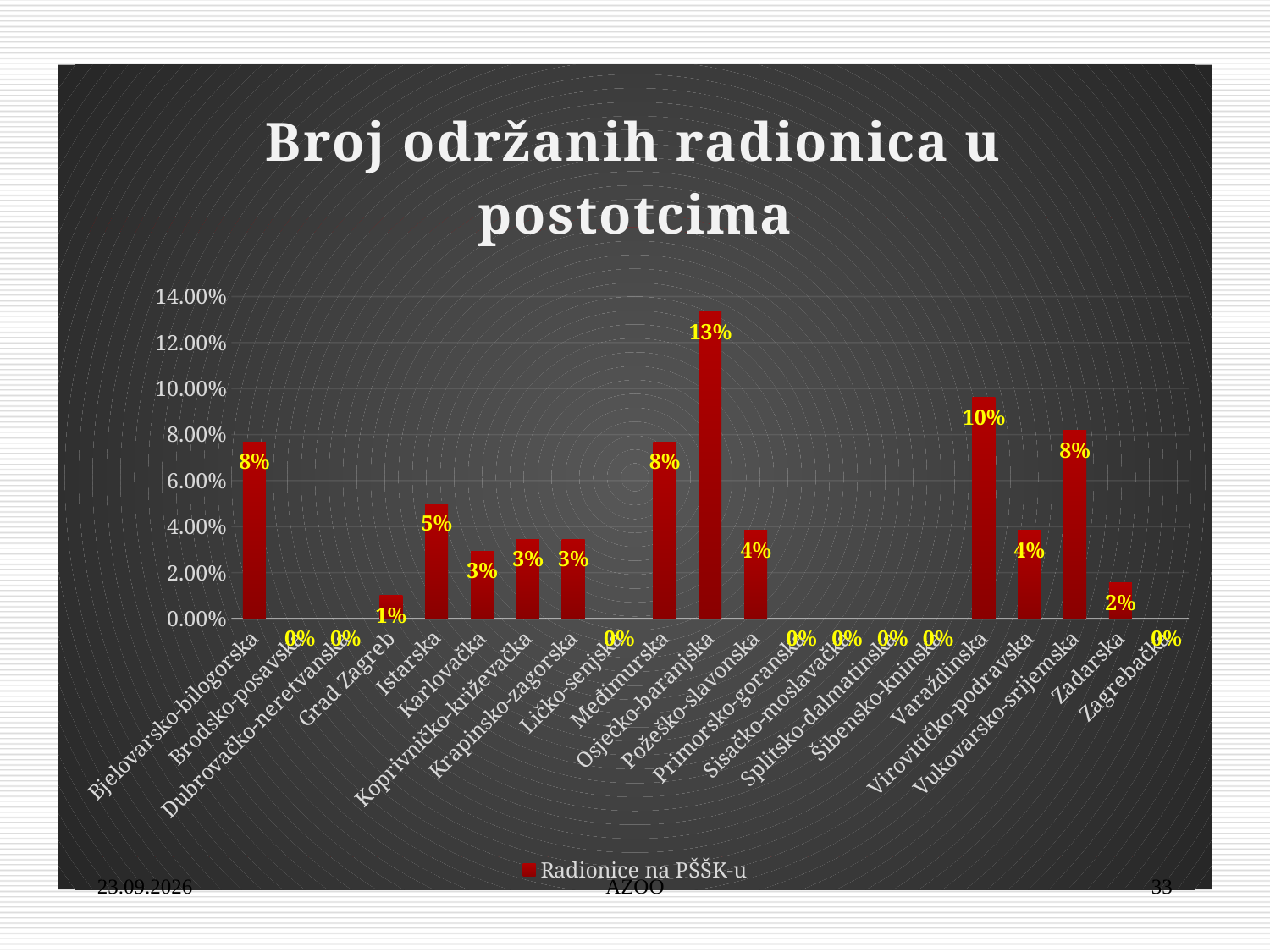
Which category has the highest value? Osječko-baranjska What is the value for Zadarska? 2% What is the difference between the values for Osječko-baranjska and Varaždinska? 3% What is the value for Grad Zagreb? 1% Which is larger, the value for Istarska or the value for Karlovačka? Istarska What is the value for Osječko-baranjska? 13% What kind of chart is shown on the slide? bar chart Is the value for Osječko-baranjska greater or less than 12.00%? greater How many categories are shown on the x axis? 21 How many series does the legend list? 1 What is the title of the chart? Broj održanih radionica u postotcima What is the value for Varaždinska? 10%